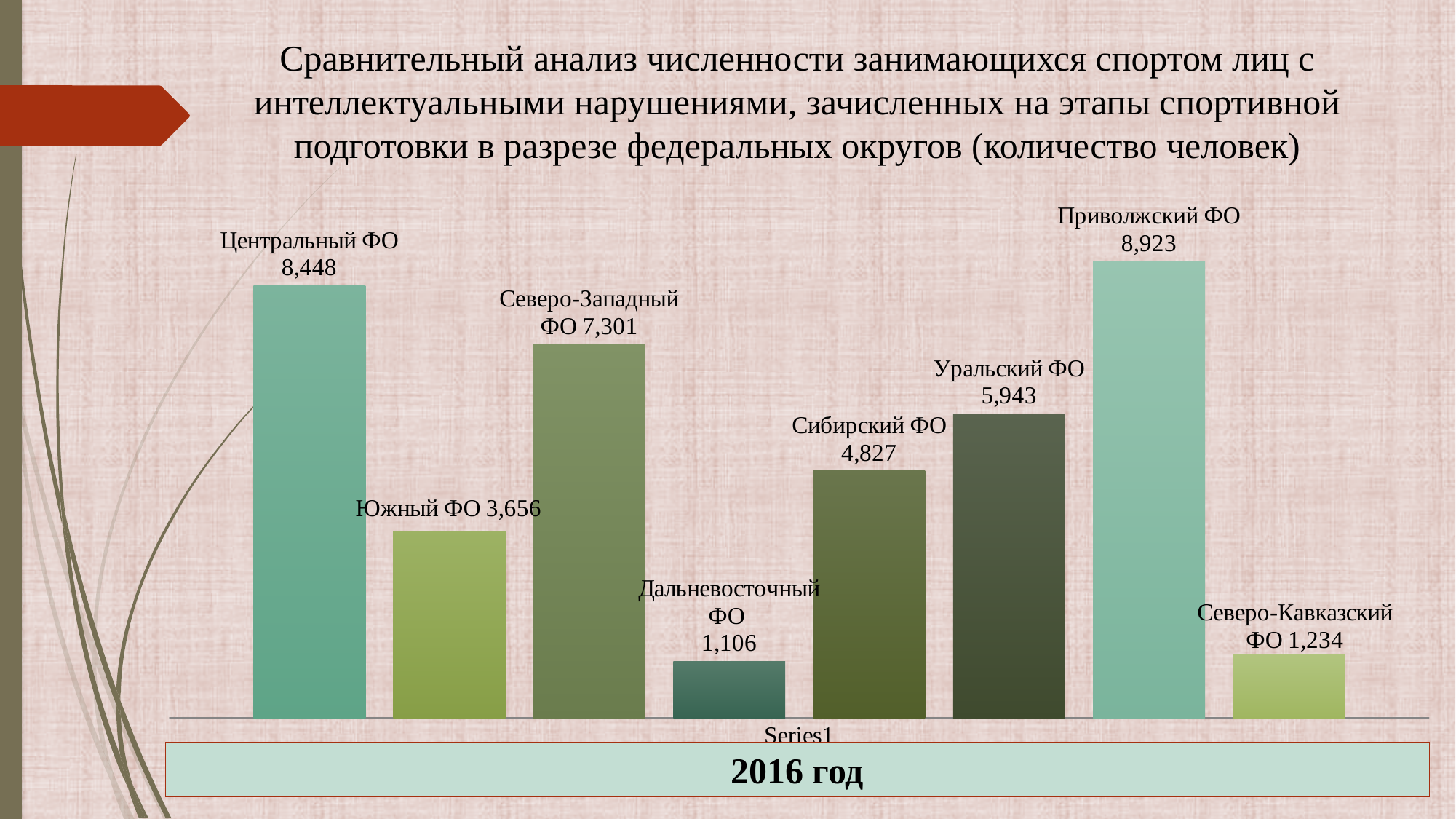
What kind of chart is shown on the slide? Bar chart What year is indicated below the chart? 2016 год Which is larger, the value for Северо-Западный ФО or the value for Уральский ФО? Северо-Западный ФО How many federal districts are shown in the chart? 8 What is the difference between the values for Приволжский ФО and Центральный ФО? 475 What is the value for Сибирский ФО? 4,827 Which federal district has the lowest value? Дальневосточный ФО What is the value for Центральный ФО? 8,448 What is the difference between the values for Уральский ФО and Южный ФО? 2,287 Which is larger, the value for Северо-Кавказский ФО or the value for Дальневосточный ФО? Северо-Кавказский ФО Which federal district has the highest value? Приволжский ФО What is the value for Дальневосточный ФО? 1,106